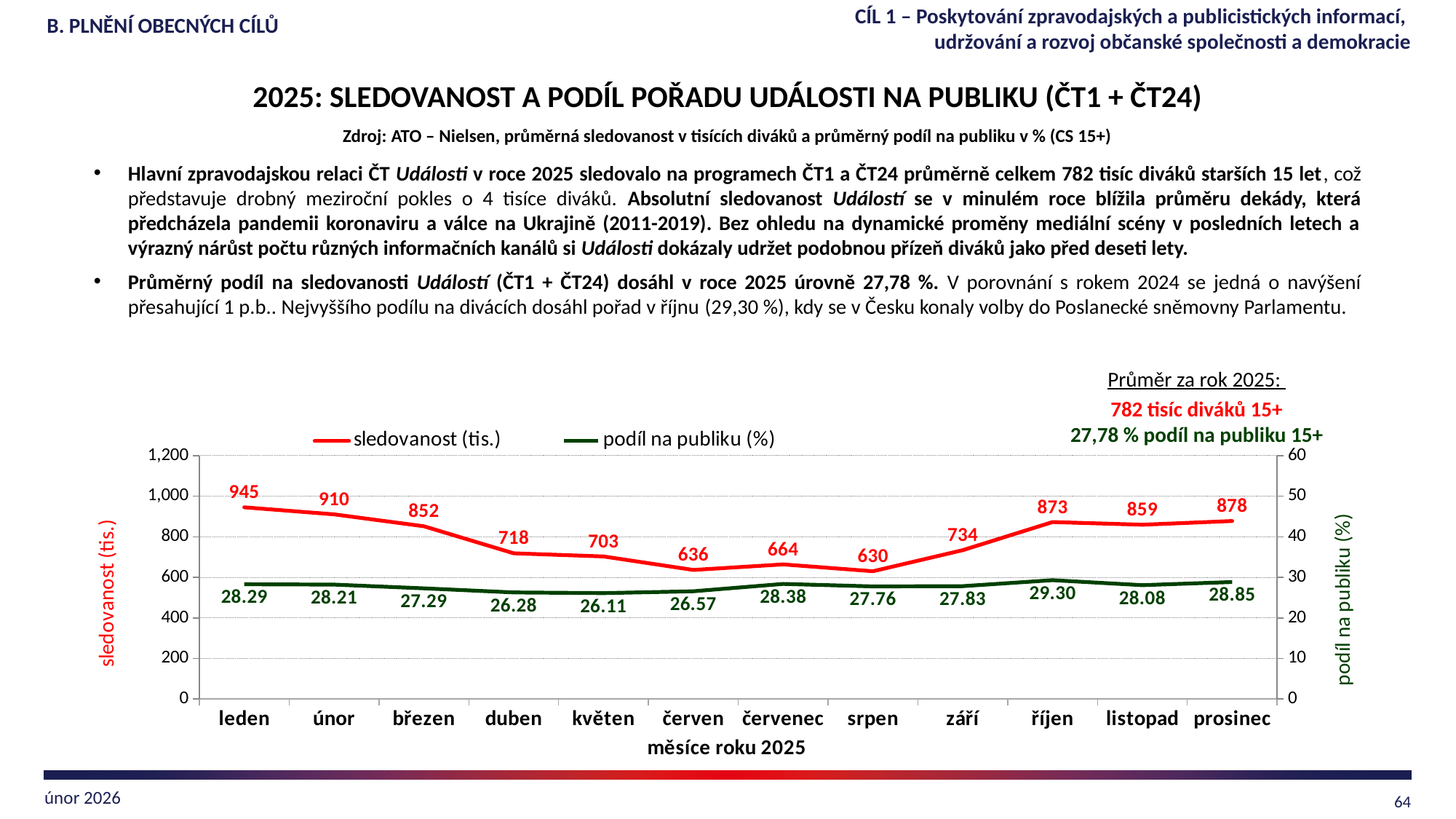
Which month has the lowest podíl na publiku (%) value? květen How many months are plotted on the x axis? 12 What is the sledovanost (tis.) value for leden? 945 What kind of chart is shown on the slide? line chart Which month has the highest sledovanost (tis.) value? leden What is the difference in sledovanost (tis.) between leden and únor? 35 What is the podíl na publiku (%) value for říjen? 29.30 Does the sledovanost (tis.) series rise or fall from leden to duben? fall Is the sledovanost (tis.) value for říjen greater or less than the value for listopad? greater Which month has the lowest sledovanost (tis.) value? srpen How many series does the legend list? 2 What is the label of the x axis? měsíce roku 2025